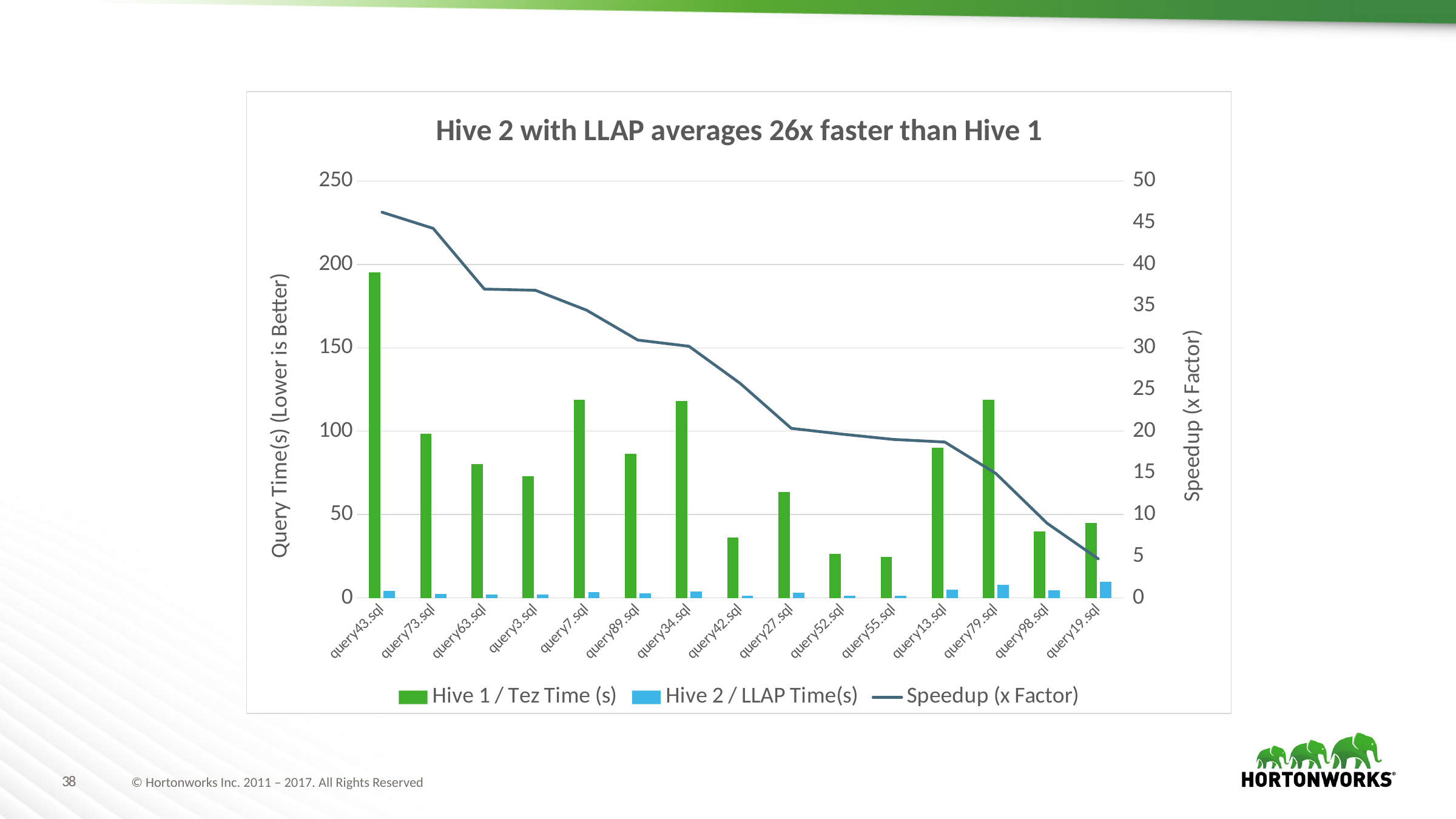
Is the Speedup (x Factor) for query73.sql greater or less than 40? greater Is the Hive 1 / Tez Time (s) for query43.sql greater or less than 150? greater Does the Speedup (x Factor) line generally rise or fall from left to right across the queries? fall Is the Hive 1 / Tez Time (s) for query42.sql greater or less than 50? less How many queries are shown along the x axis? 15 How many series does the legend list? 3 Which has the larger Hive 1 / Tez Time (s), query13.sql or query79.sql? query79.sql Which query has the highest Hive 1 / Tez Time (s)? query43.sql What is the title of the chart? Hive 2 with LLAP averages 26x faster than Hive 1 What kind of chart is shown on the slide? A combined bar and line chart Which query has the highest Speedup (x Factor)? query43.sql Which query has the lowest Speedup (x Factor)? query19.sql